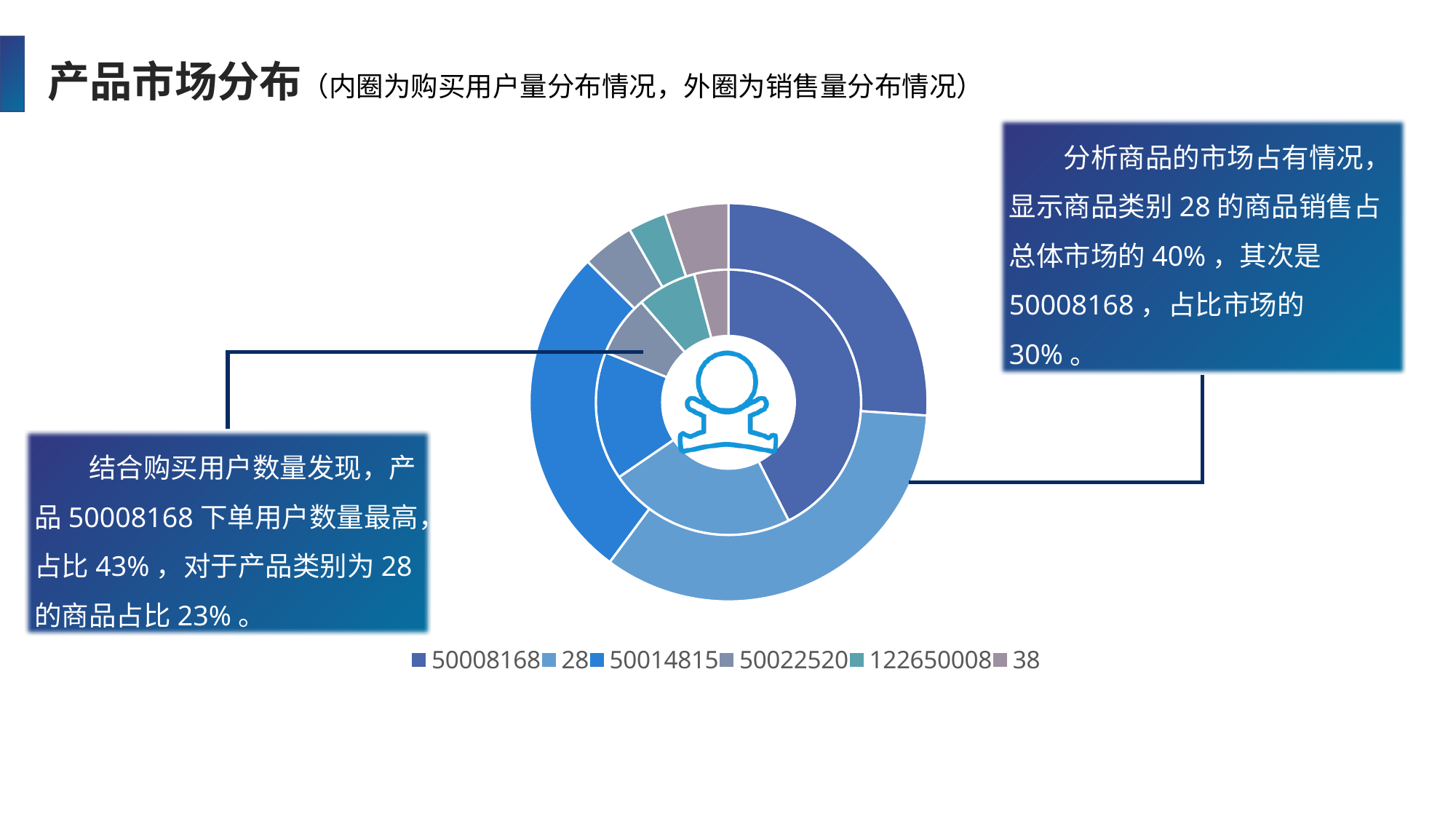
What kind of chart is shown on the slide? doughnut chart According to the slide, what share of total sales does category 28 account for? 40% How many categories does the chart legend list? 6 What is the difference between the sales share of category 28 (40%) and category 50008168 (30%)? 10% According to the slide, what share of purchasing users does product 50008168 account for? 43% In the inner ring, which slice is larger: 50008168 or 28? 50008168 What does the inner ring of the chart represent, according to the slide title? 购买用户量分布情况 According to the slide, what share of total sales does category 50008168 account for? 30% In the inner ring (purchasing user distribution), which category has the largest slice? 50008168 In the outer ring (sales volume distribution), which category has the largest slice? 28 How many rings (series) does the doughnut chart have? 2